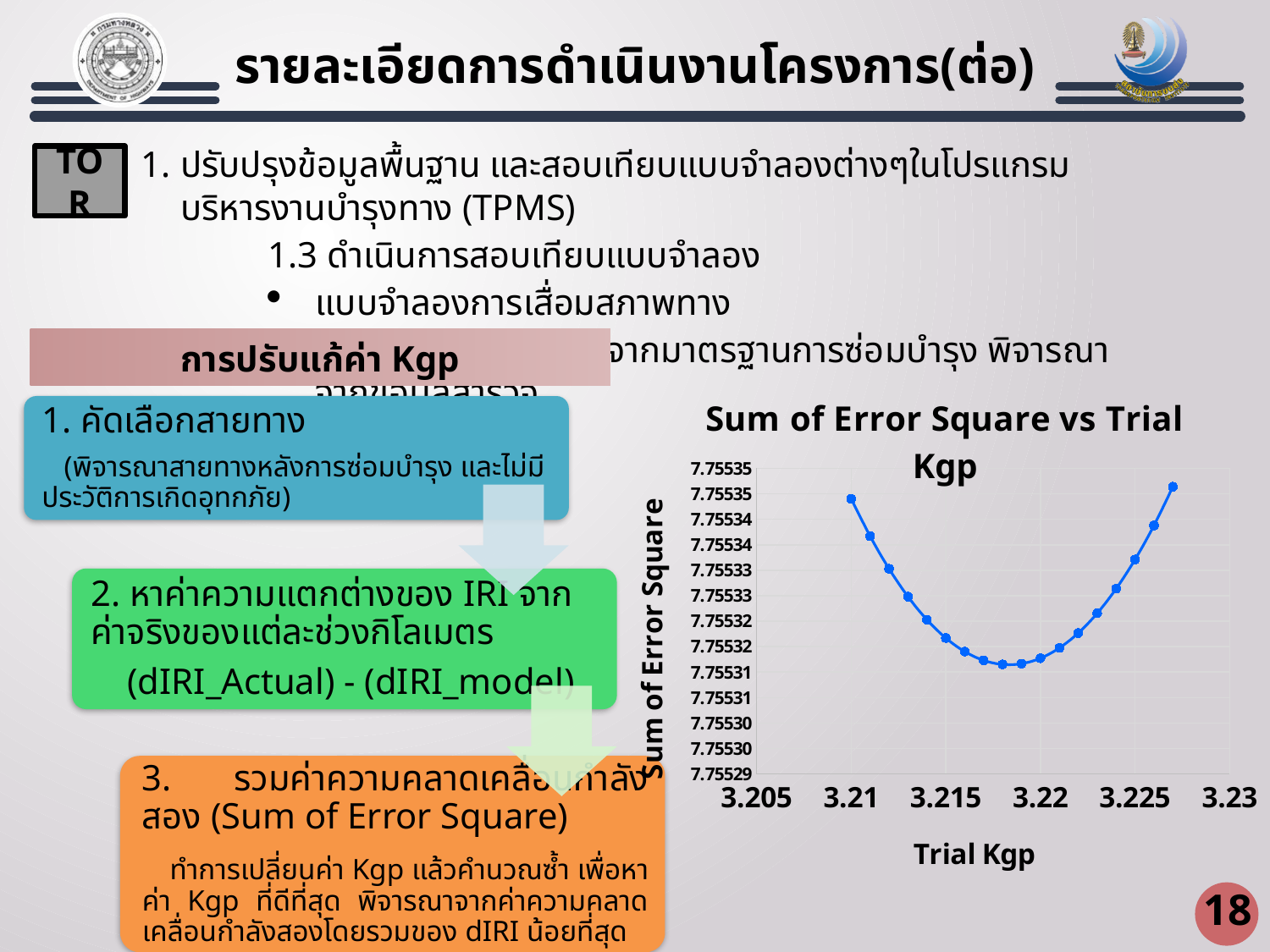
Which has the higher Sum of Error Square: Trial Kgp 3.215 or Trial Kgp 3.225? 3.225 What overall shape does the plotted curve have across the x axis? U-shaped (falls then rises) Do the values rise or fall as Trial Kgp increases from 3.22 to 3.225? Rise Do the values rise or fall as Trial Kgp increases from 3.21 to 3.215? Fall Between which two x-axis ticks does the lowest point of the curve lie? 3.215 and 3.22 What is the title of the chart? Sum of Error Square vs Trial Kgp How many data series are plotted in the chart? 1 Is the Sum of Error Square at Trial Kgp 3.21 larger or smaller than at Trial Kgp 3.22? Larger What is the label of the x axis of the chart? Trial Kgp What is the lowest tick value shown on the x axis? 3.205 What kind of chart is shown on the slide? Line chart